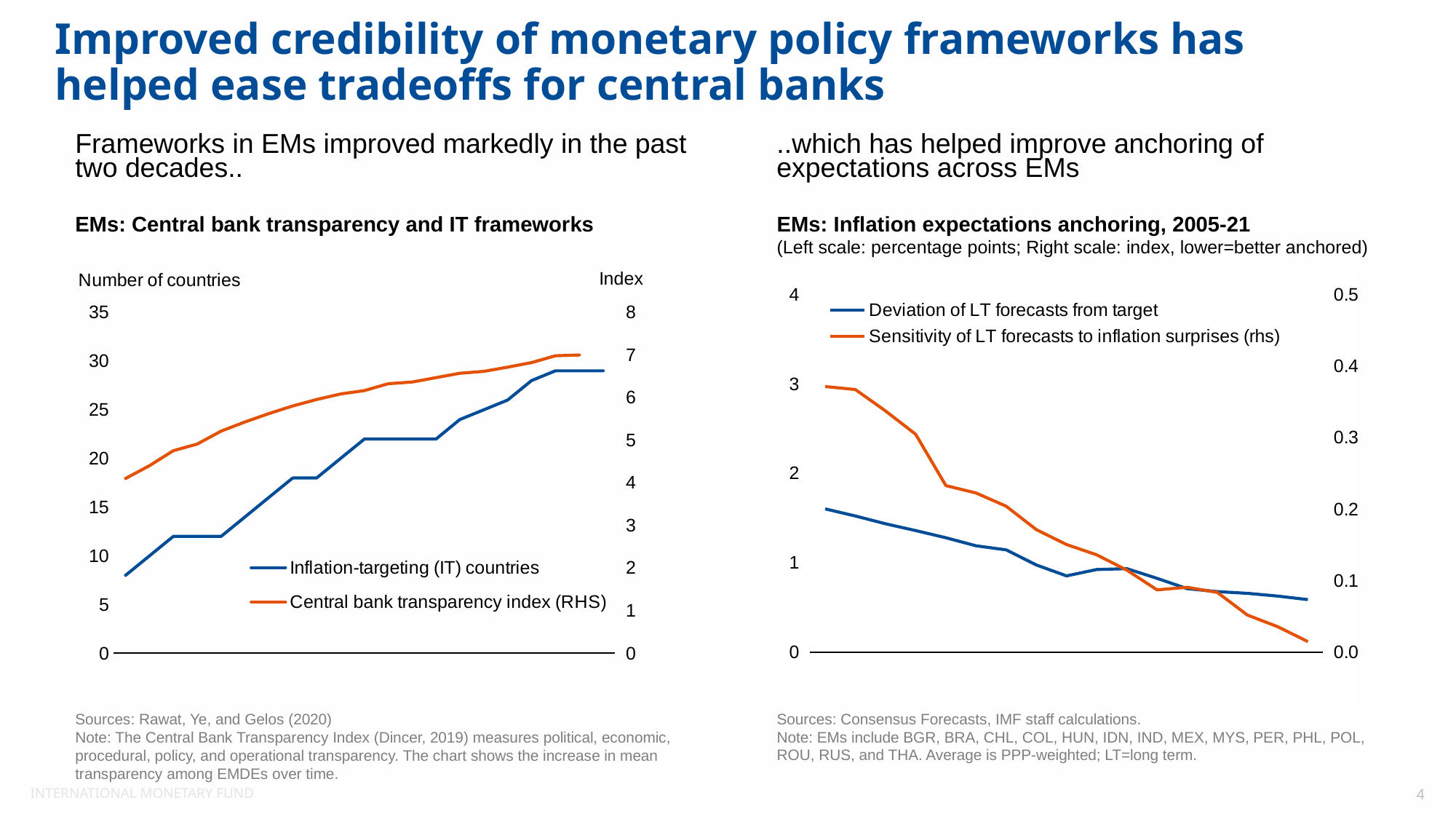
Which series in the right chart, 'EMs: Inflation expectations anchoring, 2005-21', is drawn in orange? Sensitivity of LT forecasts to inflation surprises (rhs) What is the label of the left vertical axis of the left chart, 'EMs: Central bank transparency and IT frameworks'? Number of countries In the right chart, 'EMs: Inflation expectations anchoring, 2005-21', is the final value of the 'Sensitivity of LT forecasts to inflation surprises (rhs)' line greater or less than 0.1? less In the left chart, 'EMs: Central bank transparency and IT frameworks', does the 'Inflation-targeting (IT) countries' line rise or fall along the x axis? Rise In the left chart, 'EMs: Central bank transparency and IT frameworks', is the final value of the 'Central bank transparency index (RHS)' line greater or less than 6? greater In the right chart, 'EMs: Inflation expectations anchoring, 2005-21', does the 'Sensitivity of LT forecasts to inflation surprises (rhs)' line rise or fall along the x axis? Fall How many series does the legend of the right chart, 'EMs: Inflation expectations anchoring, 2005-21', list? 2 What kind of chart is the right chart, 'EMs: Inflation expectations anchoring, 2005-21'? Line chart In the right chart, 'EMs: Inflation expectations anchoring, 2005-21', is the starting value of the 'Deviation of LT forecasts from target' line greater or less than 1? greater What kind of chart is the left chart, 'EMs: Central bank transparency and IT frameworks'? Line chart How many series does the legend of the left chart, 'EMs: Central bank transparency and IT frameworks', list? 2